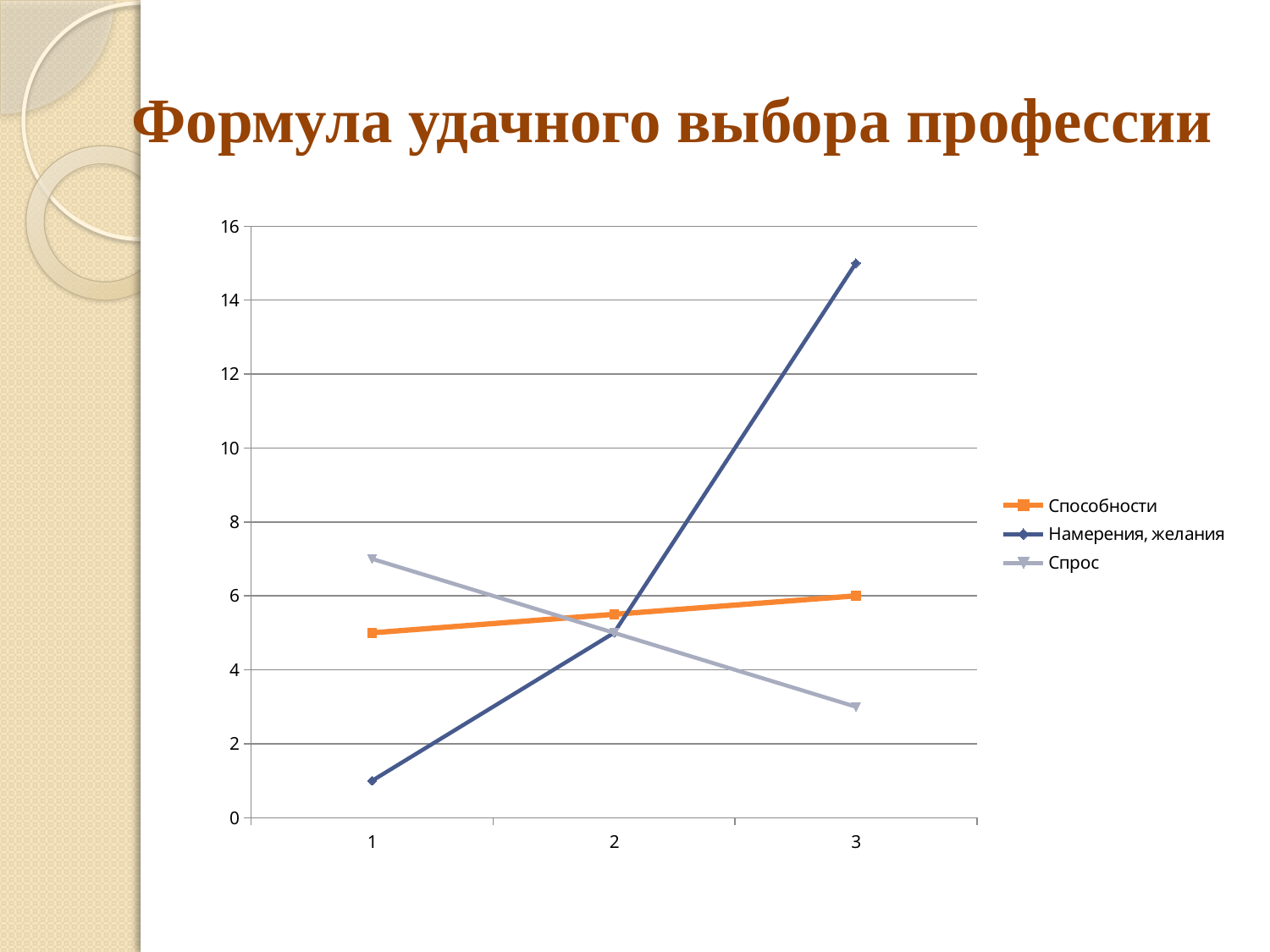
How many series does the legend list? 3 Do the values for Намерения, желания rise or fall from x = 1 to x = 3? rise Is the value for Спрос at x = 1 greater or less than 6? greater How many points are there along the x axis? 3 Do the values for Спрос rise or fall from x = 1 to x = 3? fall What kind of chart is shown on the slide? line chart Which series has the highest value at x = 3? Намерения, желания Is the value for Намерения, желания at x = 1 greater or less than 2? less What is the value of Способности at x = 3? 6 Is the value for Намерения, желания at x = 3 greater or less than 14? greater What is the title of the slide? Формула удачного выбора профессии